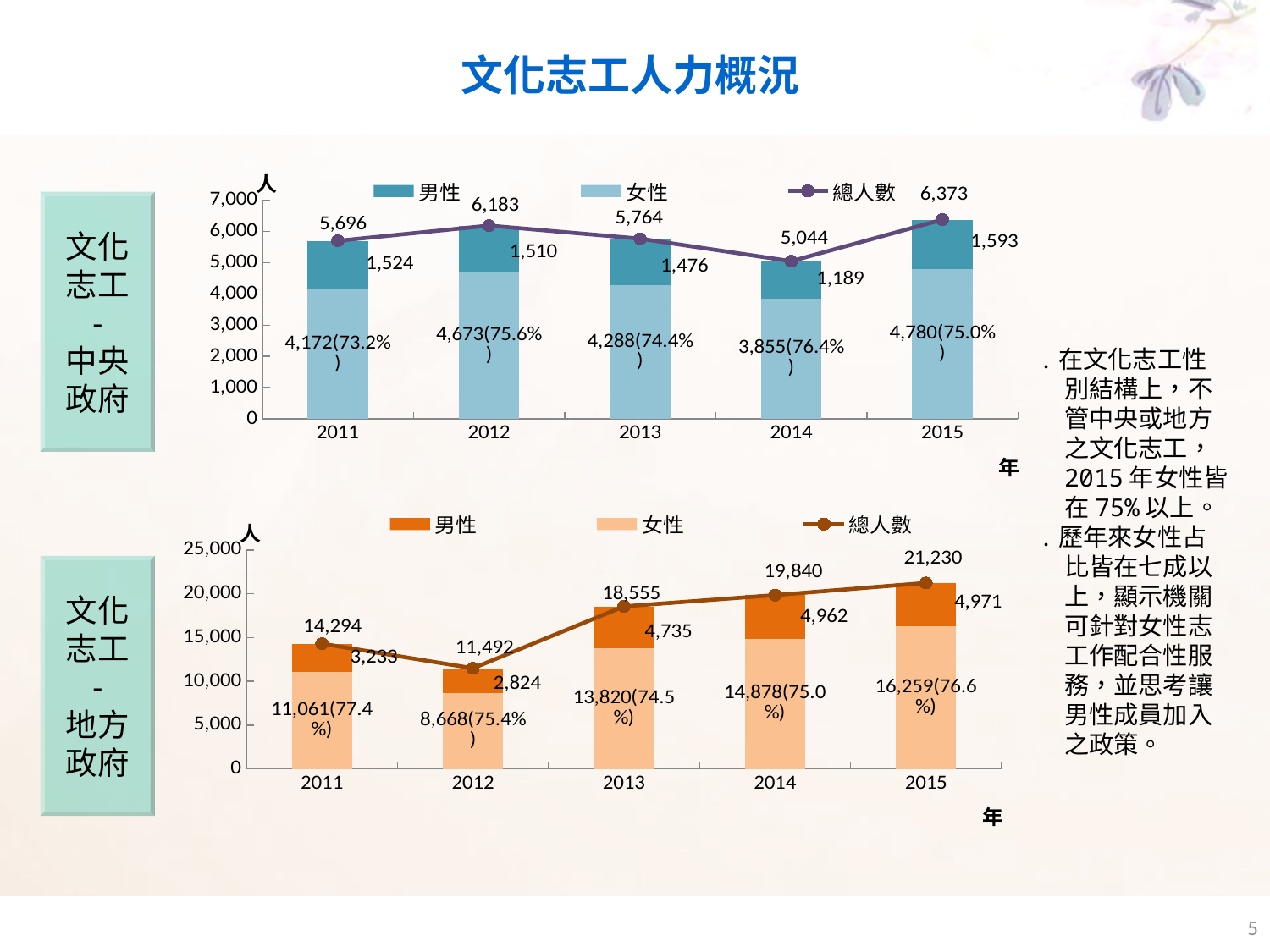
In the bottom chart (文化志工-地方政府), how many years are shown on the x axis? 5 In the top chart (文化志工-中央政府), what is the 總人數 value for 2013? 5,764 In the top chart (文化志工-中央政府), how many series does the legend list? 3 In the top chart (文化志工-中央政府), what is the 男性 value for 2015? 1,593 In the bottom chart (文化志工-地方政府), does the 總人數 rise or fall from 2012 to 2015? rise In the bottom chart (文化志工-地方政府), is the 男性 value for 2013 larger or smaller than the 男性 value for 2012? larger In the bottom chart (文化志工-地方政府), which year has the highest 總人數? 2015 In the bottom chart (文化志工-地方政府), what is the difference between the 男性 values for 2015 and 2014? 9 In the top chart (文化志工-中央政府), which year has the lowest 總人數? 2014 In the bottom chart (文化志工-地方政府), what is the 女性 value for 2014? 14,878 In the top chart (文化志工-中央政府), what is the difference between the 總人數 for 2015 and 2014? 1,329 What kind of chart is the top chart (文化志工-中央政府)? Stacked bar chart with a line